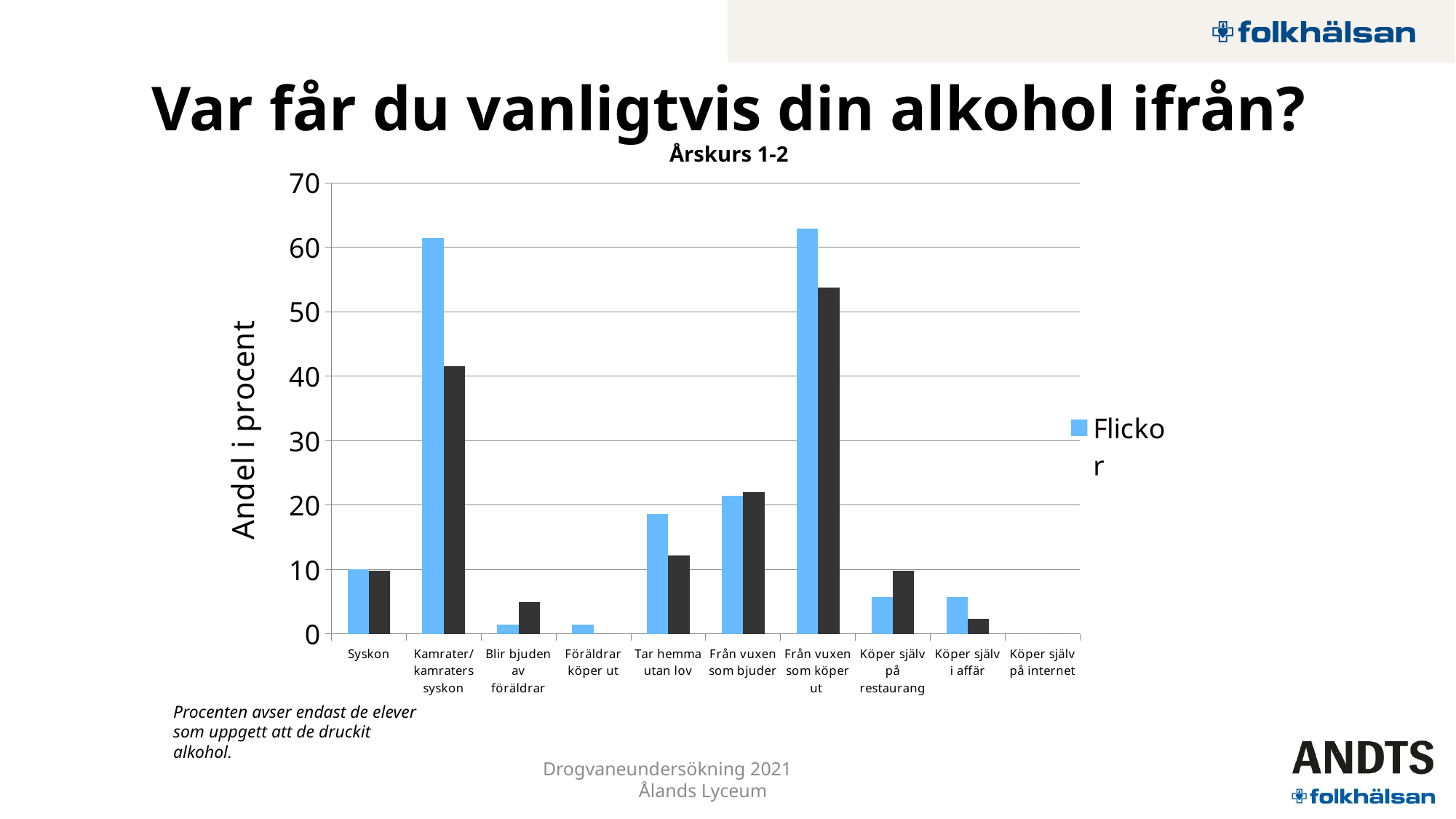
Is the Flickor value for Köper själv i affär greater or less than 10? less What is the title of the chart's vertical axis? Andel i procent What is the subtitle shown directly above the chart? Årskurs 1-2 How many categories are shown along the x axis of the chart? 10 For Blir bjuden av föräldrar, which series has the larger value, Flickor or the dark series? the dark series What kind of chart is shown on the slide? bar chart Is the Flickor value for Tar hemma utan lov greater or less than 20? less For the Flickor series, which category has the lowest value? Köper själv på internet For the dark series, which category has the highest value? Från vuxen som köper ut Is the Flickor value for Kamrater/kamraters syskon greater or less than 50? greater For Kamrater/kamraters syskon, which series has the larger value, Flickor or the dark series? Flickor